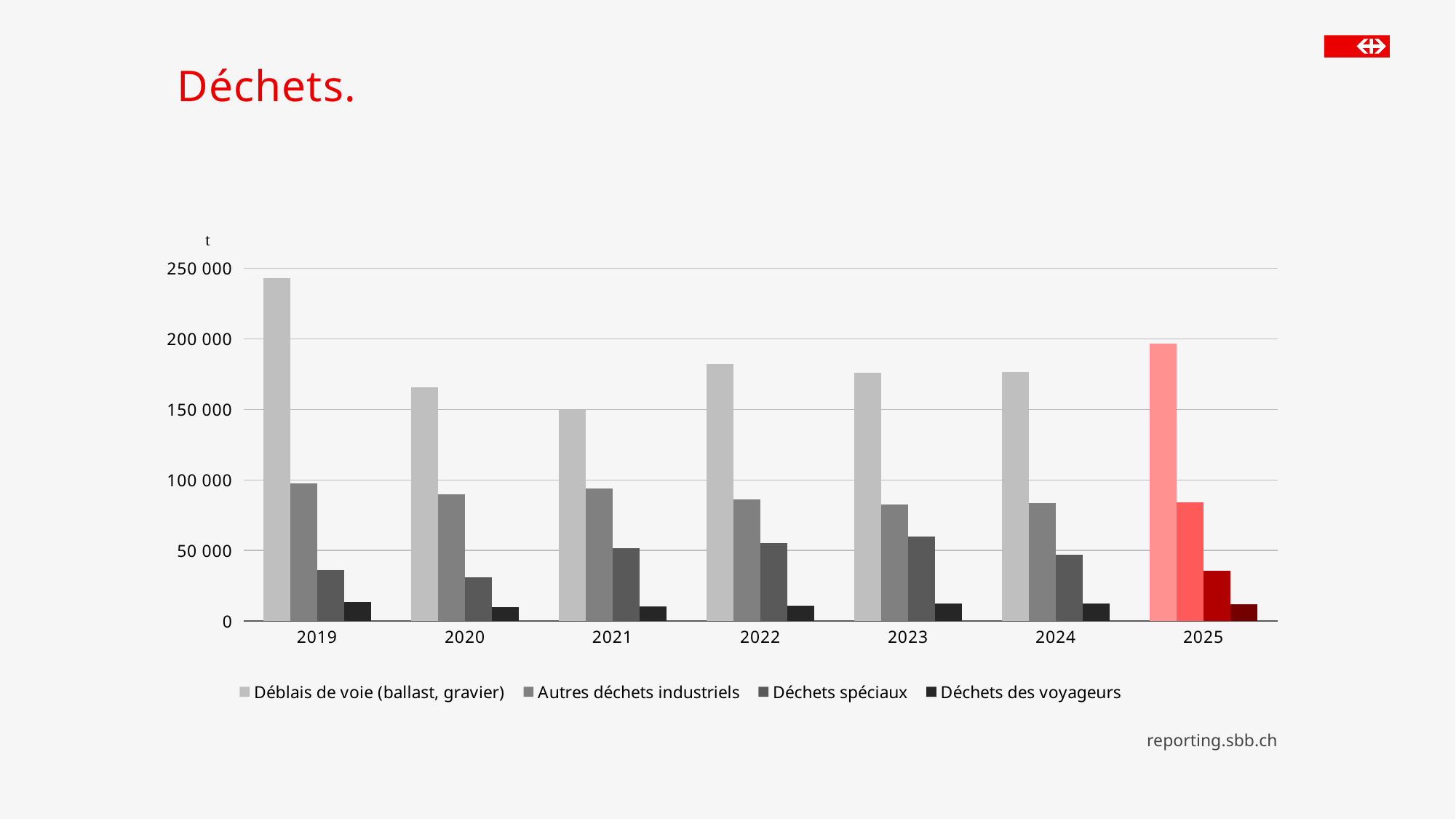
Is the value for Déchets spéciaux in 2020 greater or less than 50 000? less Which is larger for Déchets spéciaux: the value in 2020 or the value in 2023? 2023 Do the values for Déblais de voie (ballast, gravier) rise or fall from 2019 to 2021? fall Is the value for Déblais de voie (ballast, gravier) in 2019 greater or less than 200 000? greater What kind of chart is shown on the slide? bar chart Which year's bars are highlighted in red? 2025 Is the value for Déchets spéciaux in 2023 greater or less than 50 000? greater How many years are shown on the x axis? 7 In which year is the value for Déblais de voie (ballast, gravier) lowest? 2021 How many series does the legend list? 4 In which year is the value for Déblais de voie (ballast, gravier) highest? 2019